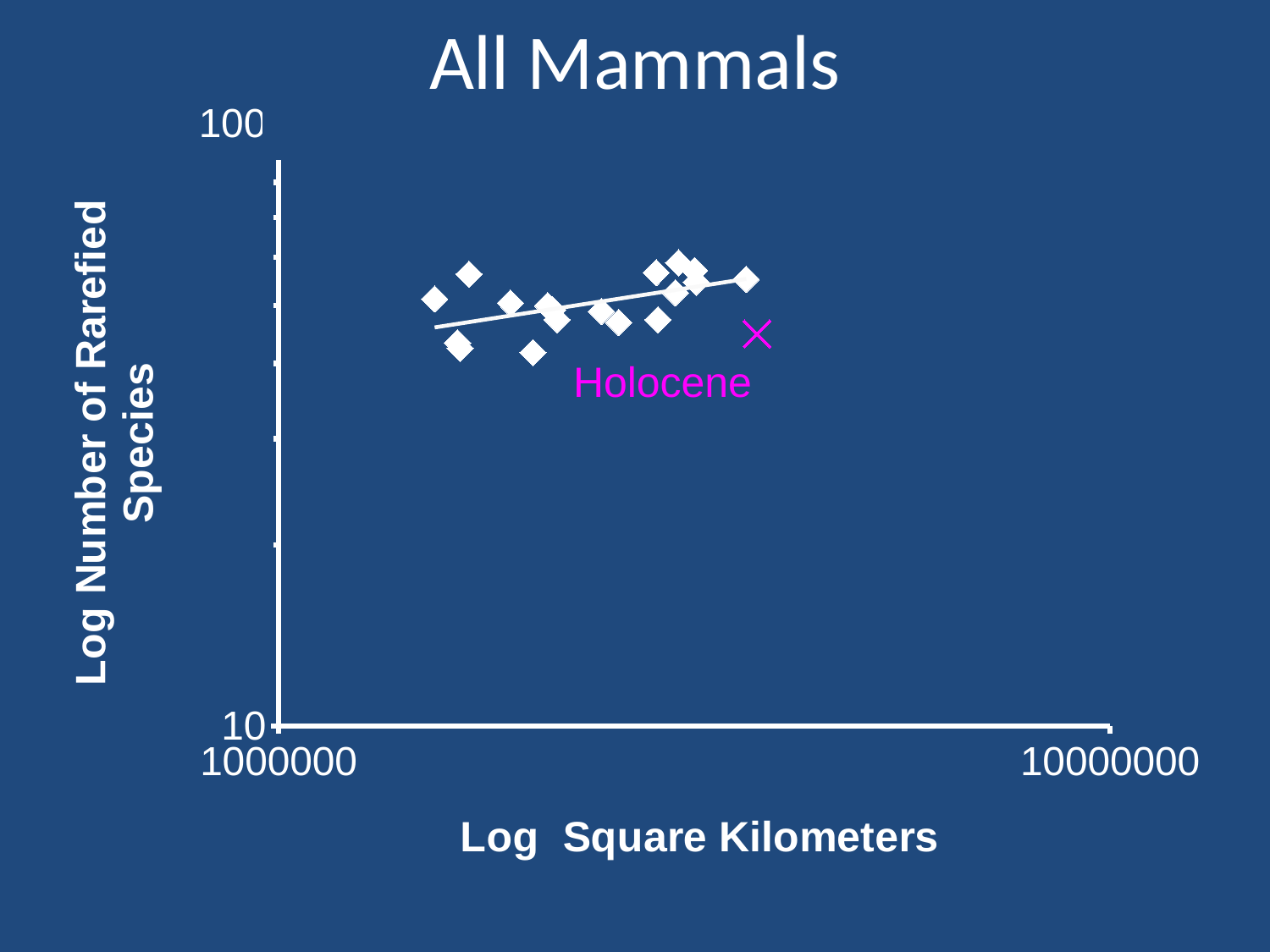
What is the lowest value shown on the y axis? 10 What is the label of the y axis? Log Number of Rarefied Species Is the value for the Holocene point greater or less than 10? greater Is the value for the Holocene point greater or less than 100? less What kind of chart is shown on the slide? Scatter plot Do the plotted diamond points and their fitted line rise or fall as the x axis increases? Rise What is the highest value shown on the x axis? 10000000 What is the title of the chart? All Mammals Is the Holocene point above or below the fitted line through the diamond points? Below Are all the diamond points plotted at values greater or less than 10 on the y axis? greater